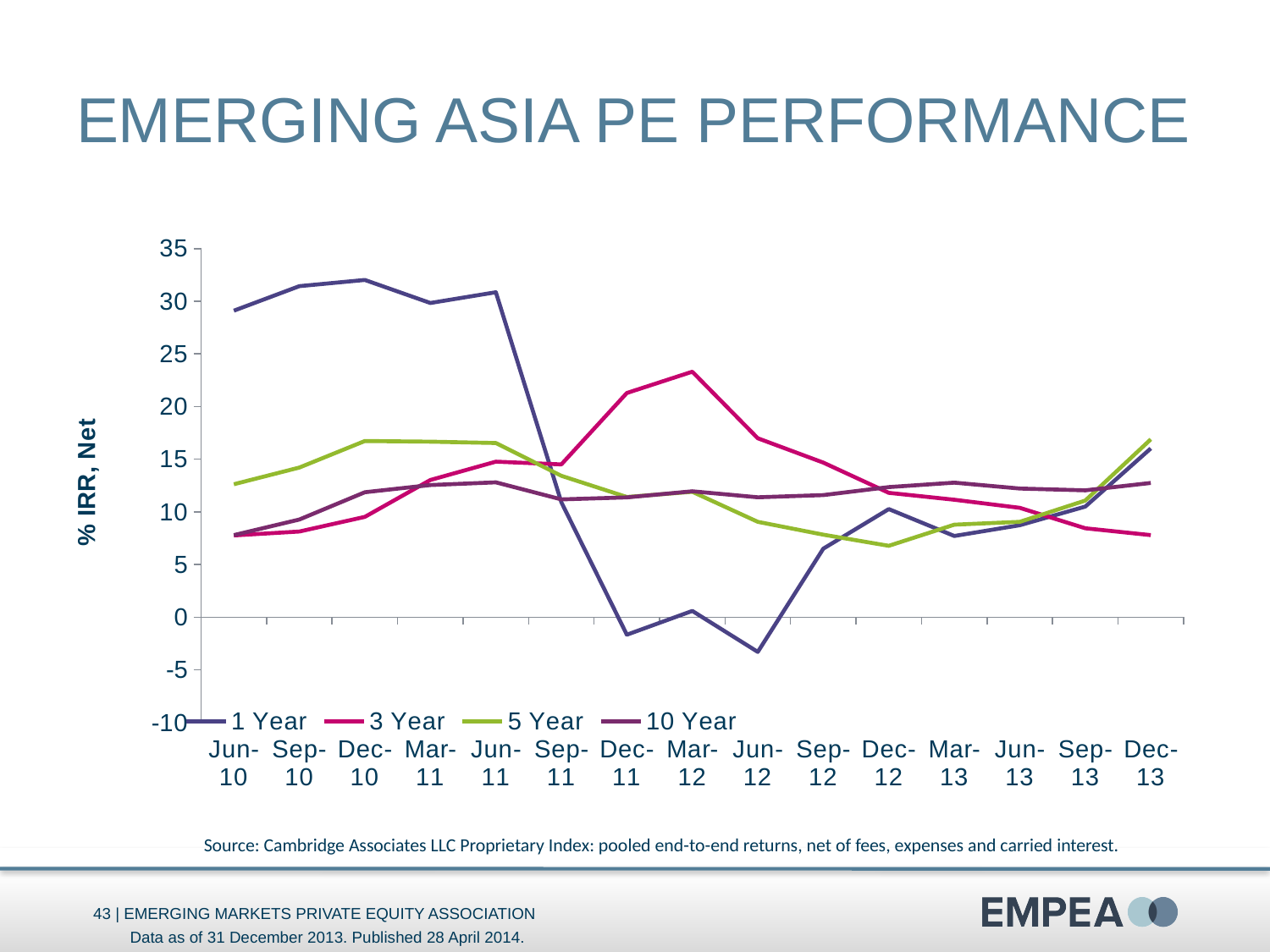
Is the 1 Year value at Jun-12 greater or less than 0? less Which series has the lowest value at Jun-12? 1 Year What is the label on the y axis? % IRR, Net What type of chart is shown on the slide? Line chart Is the 3 Year value at Mar-12 greater or less than 20? greater Is the 5 Year value at Dec-10 greater or less than 15? greater At Dec-11, which is larger: the 1 Year value or the 3 Year value? 3 Year How many series does the legend list? 4 Which series has the highest value at Jun-10? 1 Year Does the 1 Year series rise or fall between Jun-11 and Dec-11? Fall How many time periods are shown along the x axis? 15